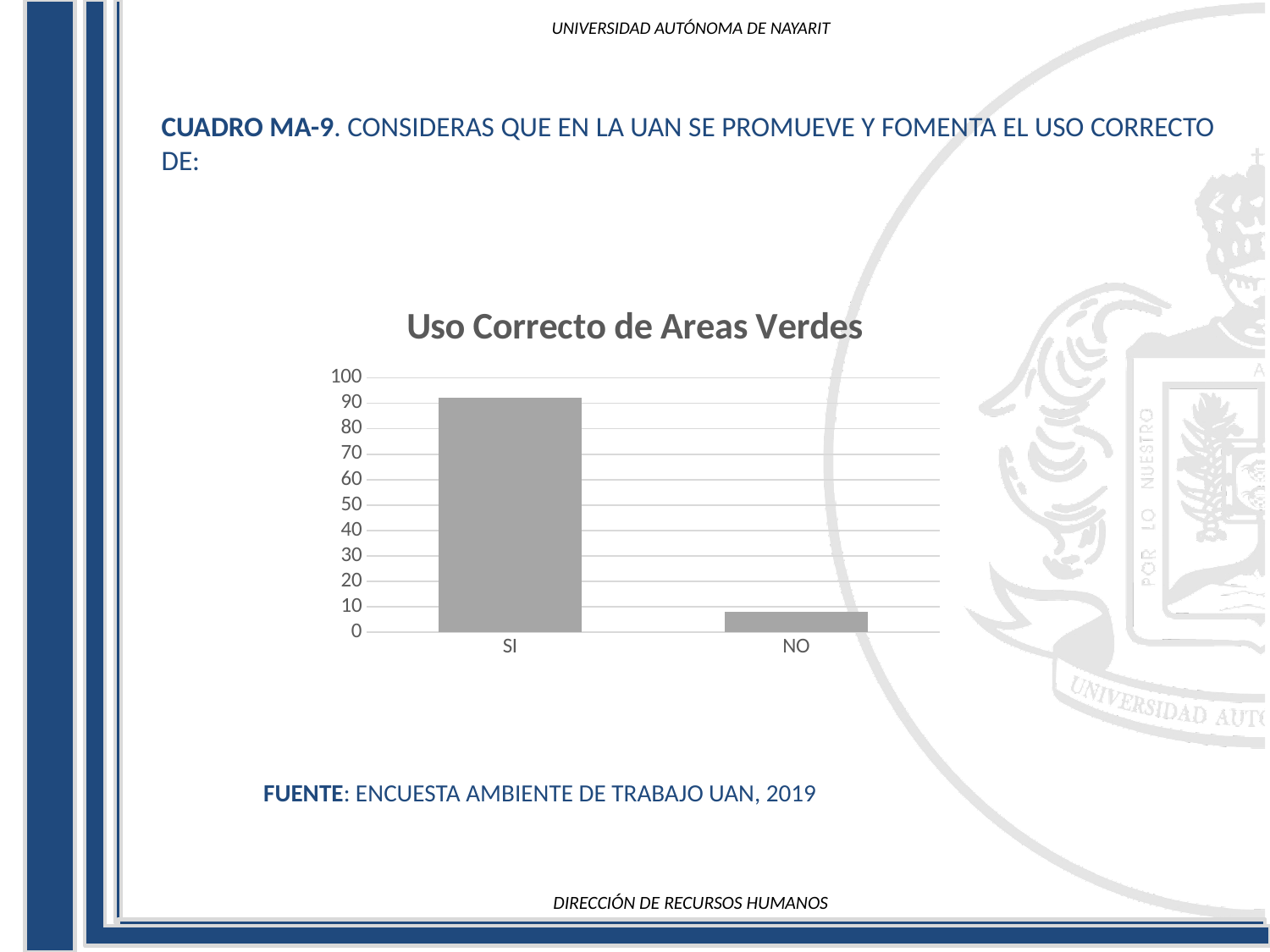
How many categories are shown on the x axis of the chart? 2 What is the title of the chart? Uso Correcto de Areas Verdes Is the value for NO greater or less than 50? less Is the value for SI greater or less than 80? greater Which category has the lowest value in the chart? NO What kind of chart is shown on the slide? bar chart Which category has the highest value in the chart? SI Is the value for NO greater or less than 20? less Which is larger, the value for SI or the value for NO? SI Do the values rise or fall from SI to NO along the x axis? fall What is the maximum value shown on the vertical axis of the chart? 100